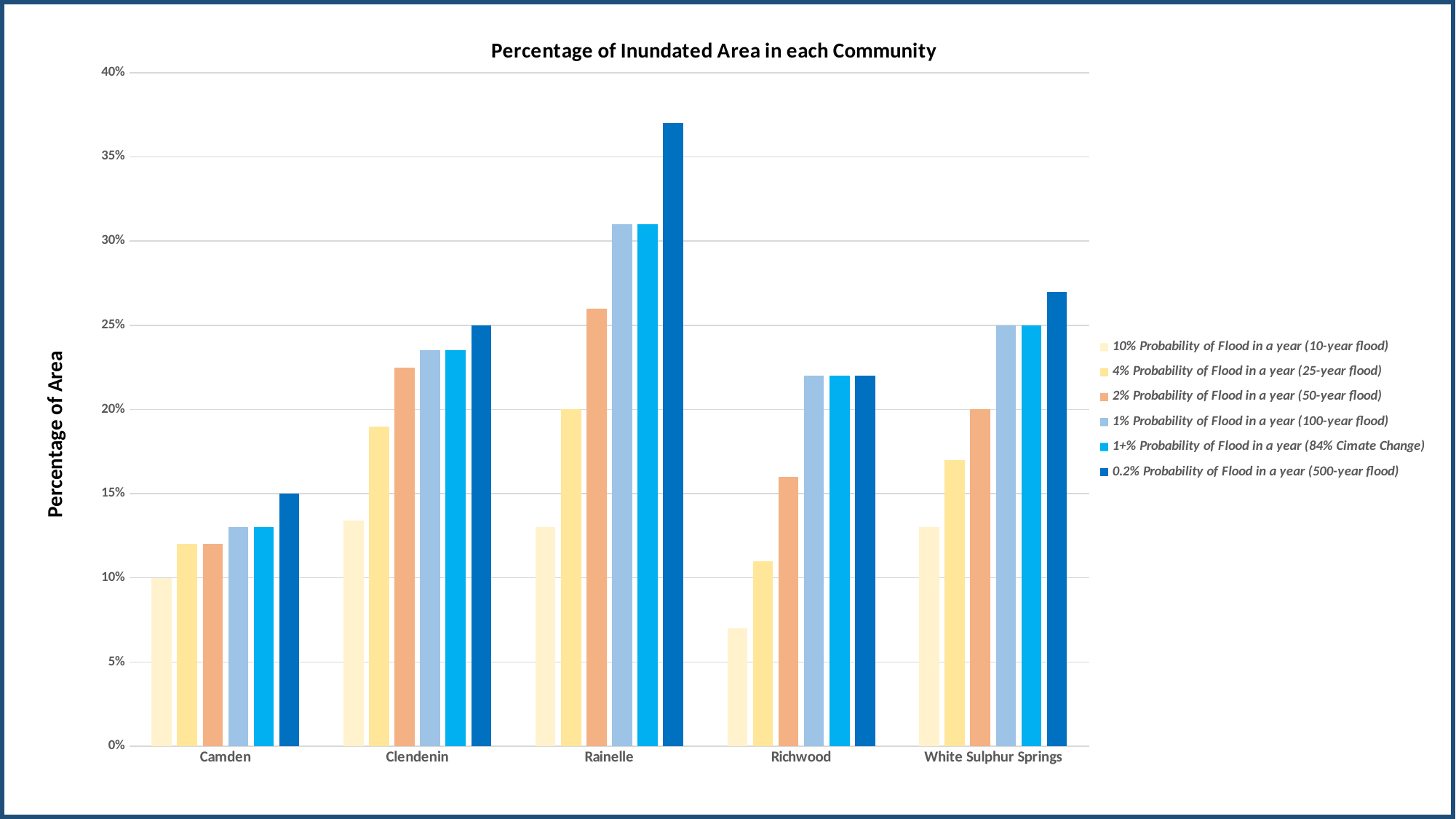
How many series does the legend list? 6 How many communities are shown on the x axis? 5 Is the value for Rainelle in the 0.2% Probability of Flood in a year (500-year flood) series greater or less than 35%? greater Which community has the lowest value for the 10% Probability of Flood in a year (10-year flood) series? Richwood Is the value for Richwood in the 2% Probability of Flood in a year (50-year flood) series greater or less than 20%? less What is the label on the vertical axis? Percentage of Area What is the title of the chart? Percentage of Inundated Area in each Community Which is larger for the 2% Probability of Flood in a year (50-year flood) series: Clendenin or Rainelle? Rainelle Is the value for White Sulphur Springs in the 0.2% Probability of Flood in a year (500-year flood) series greater or less than 25%? greater What type of chart is shown on the slide? bar chart Which community has the highest value for the 0.2% Probability of Flood in a year (500-year flood) series? Rainelle Which is larger for the 4% Probability of Flood in a year (25-year flood) series: Camden or White Sulphur Springs? White Sulphur Springs